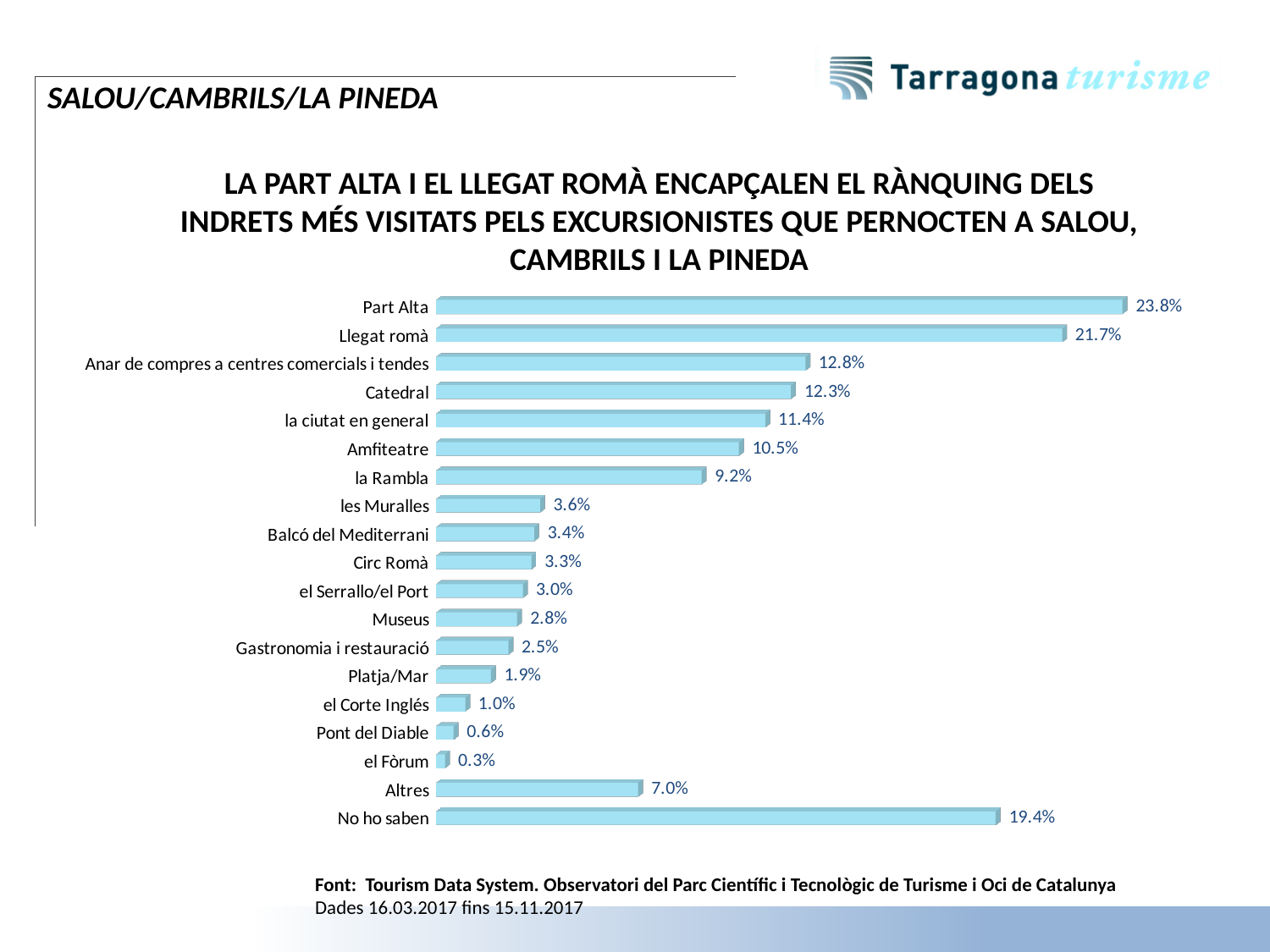
Which category has the highest value? Part Alta What is the value for Pont del Diable? 0.6% Which is larger, the value for Anar de compres a centres comercials i tendes or the value for la ciutat en general? Anar de compres a centres comercials i tendes What is the difference between the values for Catedral and la Rambla? 3.1% Which category has the lowest value? el Fòrum What is the value for Amfiteatre? 10.5% How many categories are shown in the chart? 19 What is the value for No ho saben? 19.4% What is the difference between the values for Part Alta and Llegat romà? 2.1% What is the value for Part Alta? 23.8% What kind of chart is shown on the slide? Bar chart Which is larger, the value for Altres or the value for les Muralles? Altres